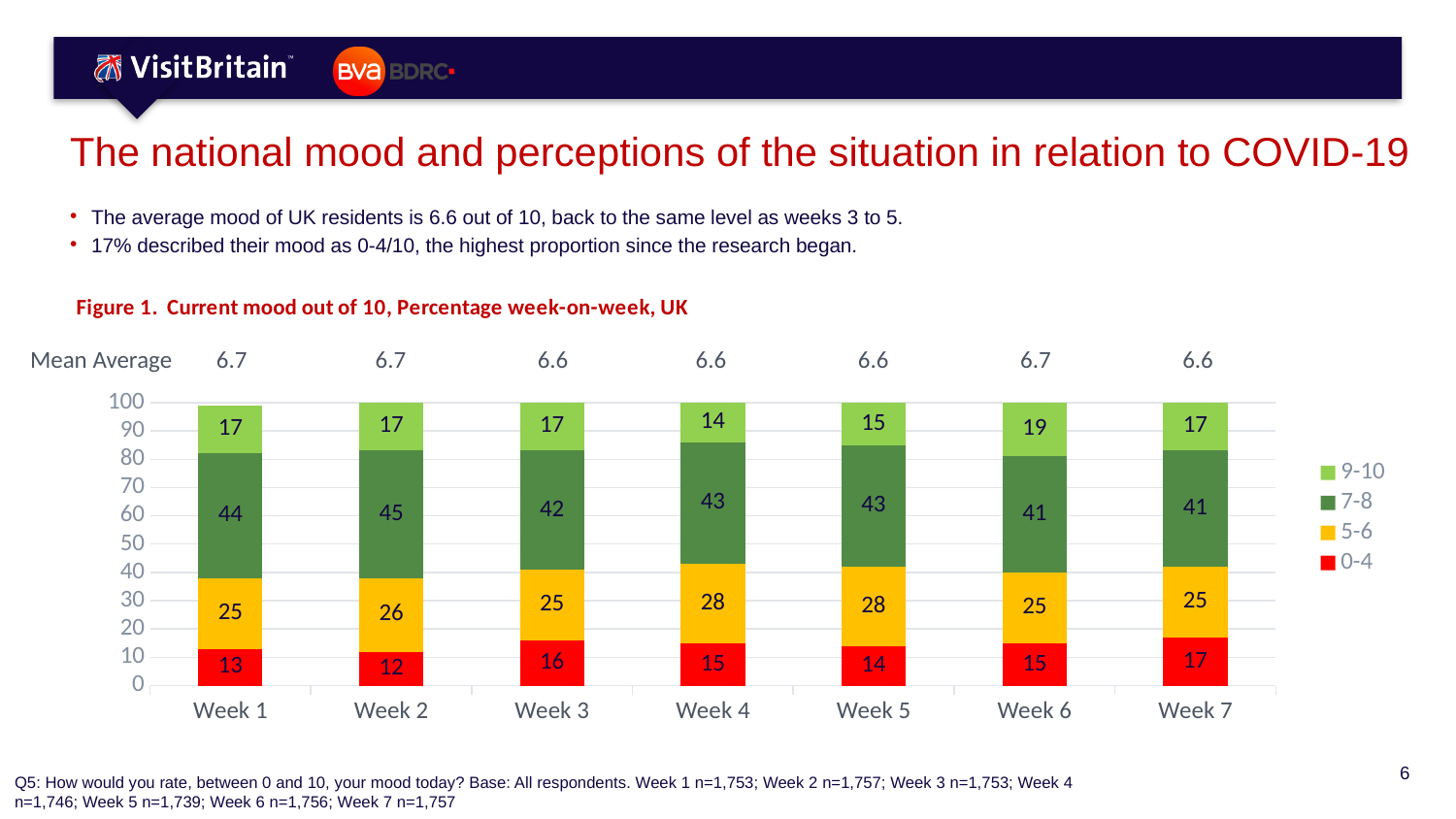
In which week is the 9-10 segment highest? Week 6 Which colour represents the 0-4 mood category in the legend? Red What percentage of respondents rated their mood 7-8 in Week 2? 45 How many series does the legend list? 4 What is the difference between the 5-6 value in Week 4 and the 5-6 value in Week 1? 3 What kind of chart is Figure 1? Stacked bar chart What percentage of respondents rated their mood 0-4 in Week 7? 17 How many weeks are shown on the x axis? 7 Which is larger: the 7-8 value in Week 3 or the 7-8 value in Week 6? Week 3 What is the mean average mood shown for Week 4? 6.6 In which week is the 0-4 segment lowest? Week 2 What is the total of the stacked bar for Week 1? 99